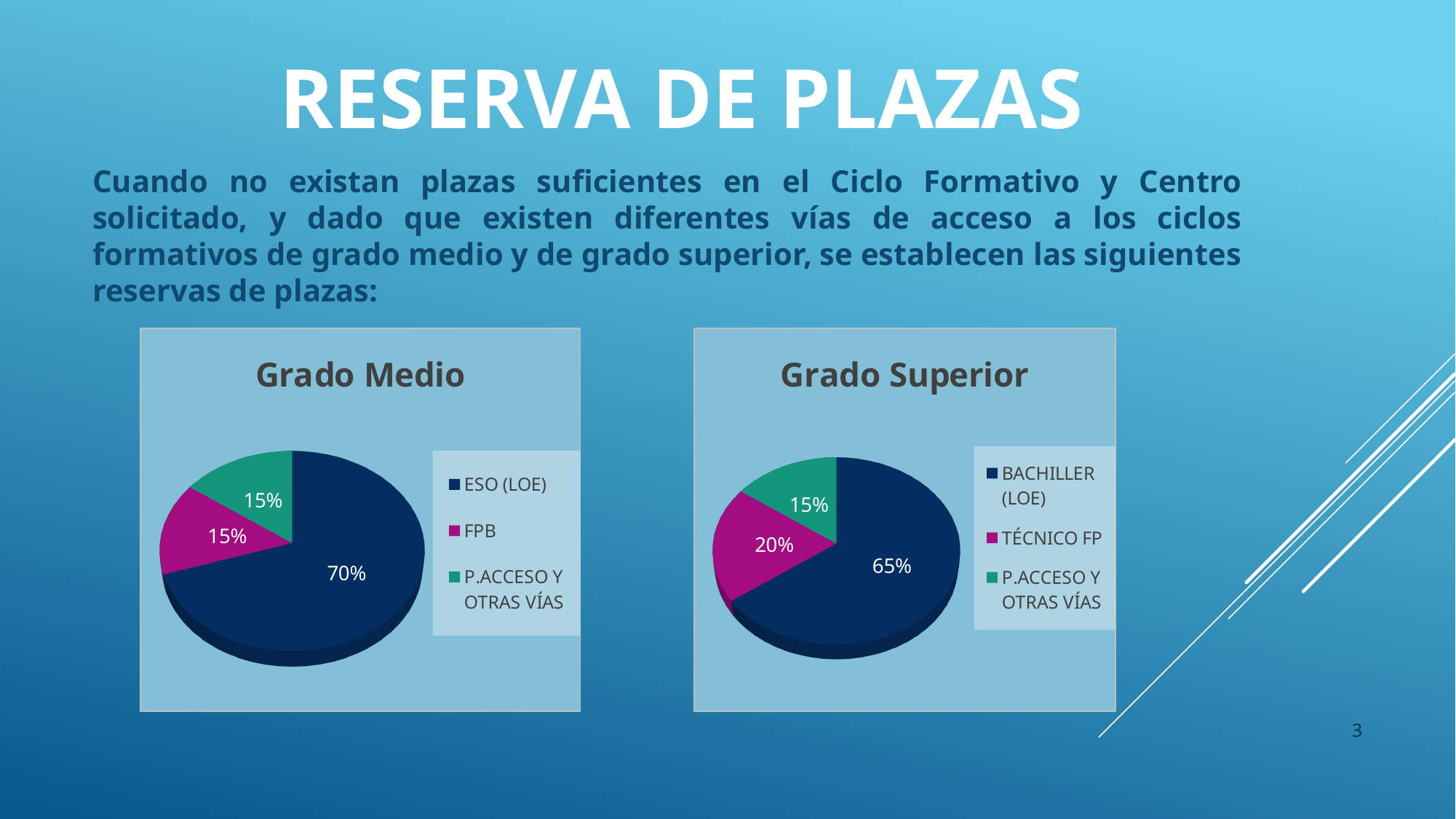
In the Grado Superior chart, what share of places is reserved for BACHILLER (LOE)? 65% In the Grado Medio chart, which category has the largest slice? ESO (LOE) In the Grado Superior chart, which category has the smallest slice? P.ACCESO Y OTRAS VÍAS How many categories does the Grado Medio chart show? 3 In the Grado Medio chart, what share of places is reserved for FPB? 15% In the Grado Superior chart, what is the difference between the BACHILLER (LOE) share and the TÉCNICO FP share? 45% In the Grado Medio chart, what share of places is reserved for ESO (LOE)? 70% Which is larger: the FPB share in the Grado Medio chart or the TÉCNICO FP share in the Grado Superior chart? TÉCNICO FP in Grado Superior In the Grado Superior chart, what share of places is reserved for TÉCNICO FP? 20% What kind of chart is the Grado Superior chart? Pie chart What colour is the P.ACCESO Y OTRAS VÍAS slice in the Grado Medio chart? Green In the Grado Superior chart, what share of places is reserved for P.ACCESO Y OTRAS VÍAS? 15%